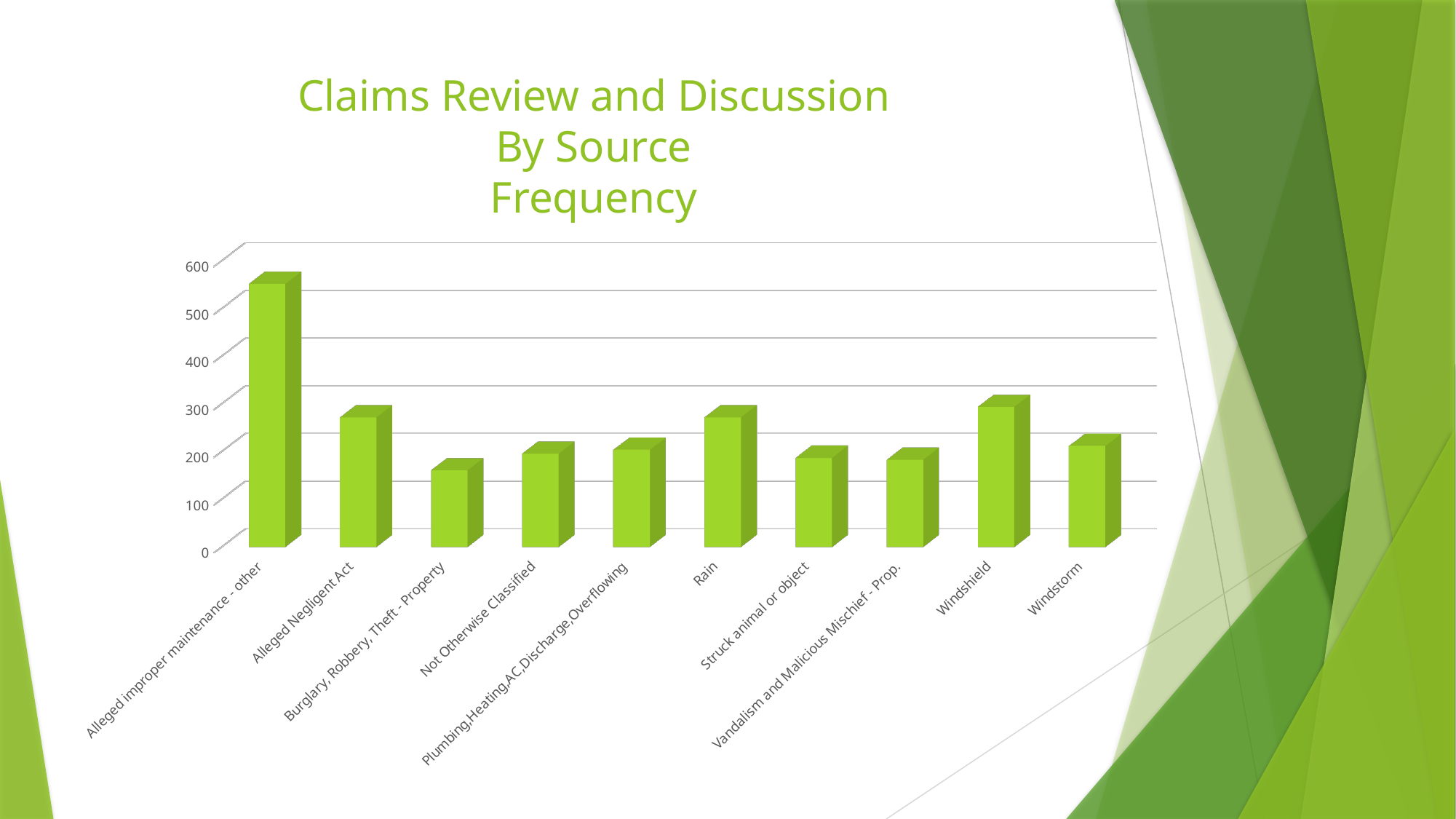
What kind of chart is shown on the slide? Bar chart Which is larger, the value for Alleged improper maintenance - other or the value for Windshield? Alleged improper maintenance - other Is the value for Windstorm greater or less than 100? greater Which category has the lowest frequency? Burglary, Robbery, Theft - Property Is the value for Alleged improper maintenance - other greater or less than 500? greater Is the value for Rain greater or less than 300? less How many categories are plotted on the chart? 10 What is the title of the chart? Claims Review and Discussion By Source Frequency Which is larger, the value for Windshield or the value for Rain? Windshield Which category has the highest frequency? Alleged improper maintenance - other